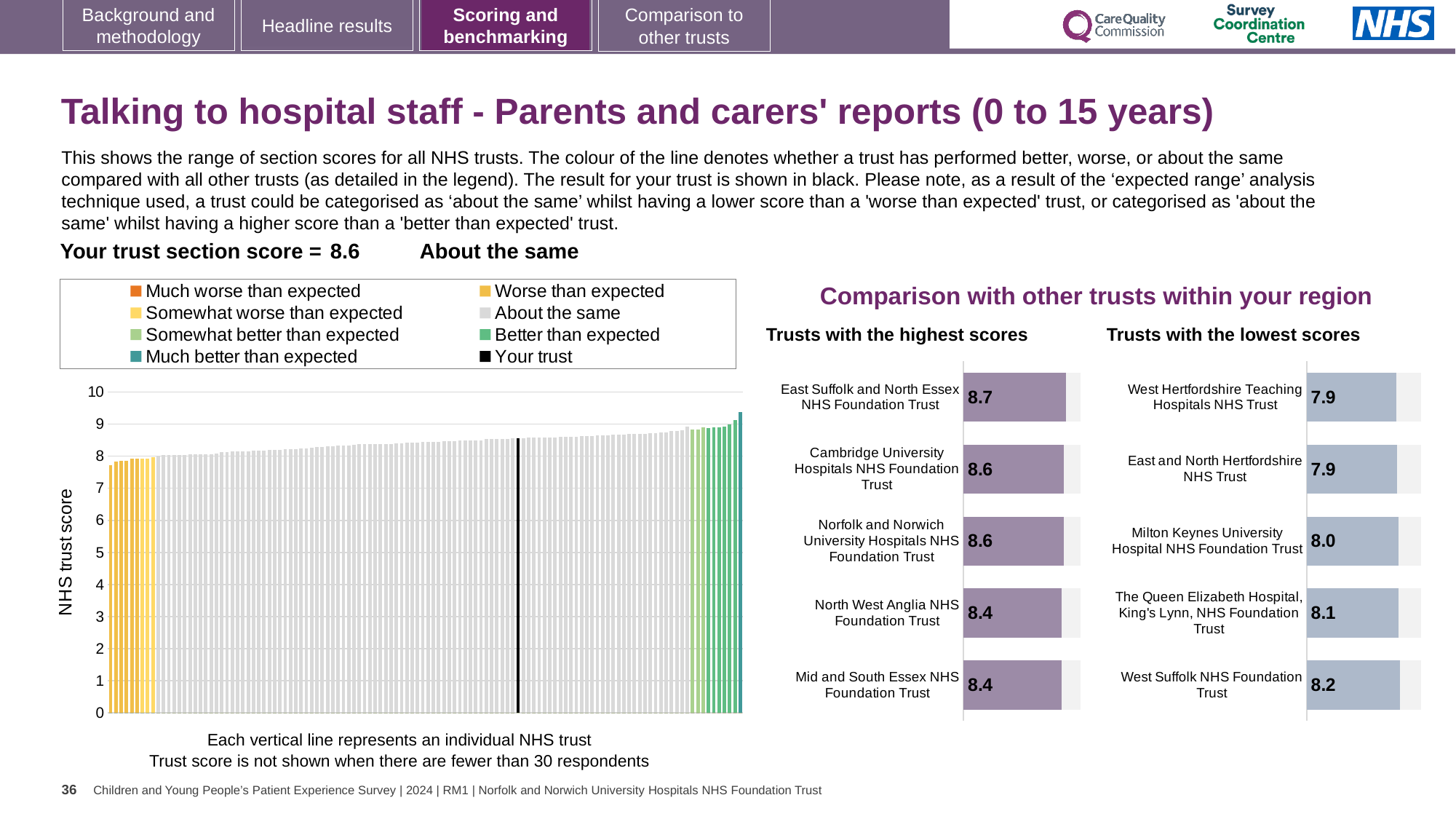
In the NHS trust score chart on the left, do the bar values rise or fall from left to right? rise In the 'Trusts with the highest scores' chart, what is the score for North West Anglia NHS Foundation Trust? 8.4 In the NHS trust score chart on the left, is the value for the black 'Your trust' bar greater or less than 8? greater In the 'Trusts with the highest scores' chart, which trust has the highest score? East Suffolk and North Essex NHS Foundation Trust In the 'Trusts with the highest scores' chart, what is the score for East Suffolk and North Essex NHS Foundation Trust? 8.7 In the 'Trusts with the highest scores' chart, what is the difference between the scores of East Suffolk and North Essex NHS Foundation Trust and Mid and South Essex NHS Foundation Trust? 0.3 In the 'Trusts with the lowest scores' chart, what is the score for West Suffolk NHS Foundation Trust? 8.2 In the 'Trusts with the lowest scores' chart, what is the score for Milton Keynes University Hospital NHS Foundation Trust? 8.0 In the 'Trusts with the lowest scores' chart, which trust has the highest score shown? West Suffolk NHS Foundation Trust In the 'Trusts with the lowest scores' chart, is the score for West Suffolk NHS Foundation Trust larger or smaller than the score for West Hertfordshire Teaching Hospitals NHS Trust? larger How many trusts are shown in the 'Trusts with the lowest scores' chart? 5 How many entries does the legend of the NHS trust score chart list? 8